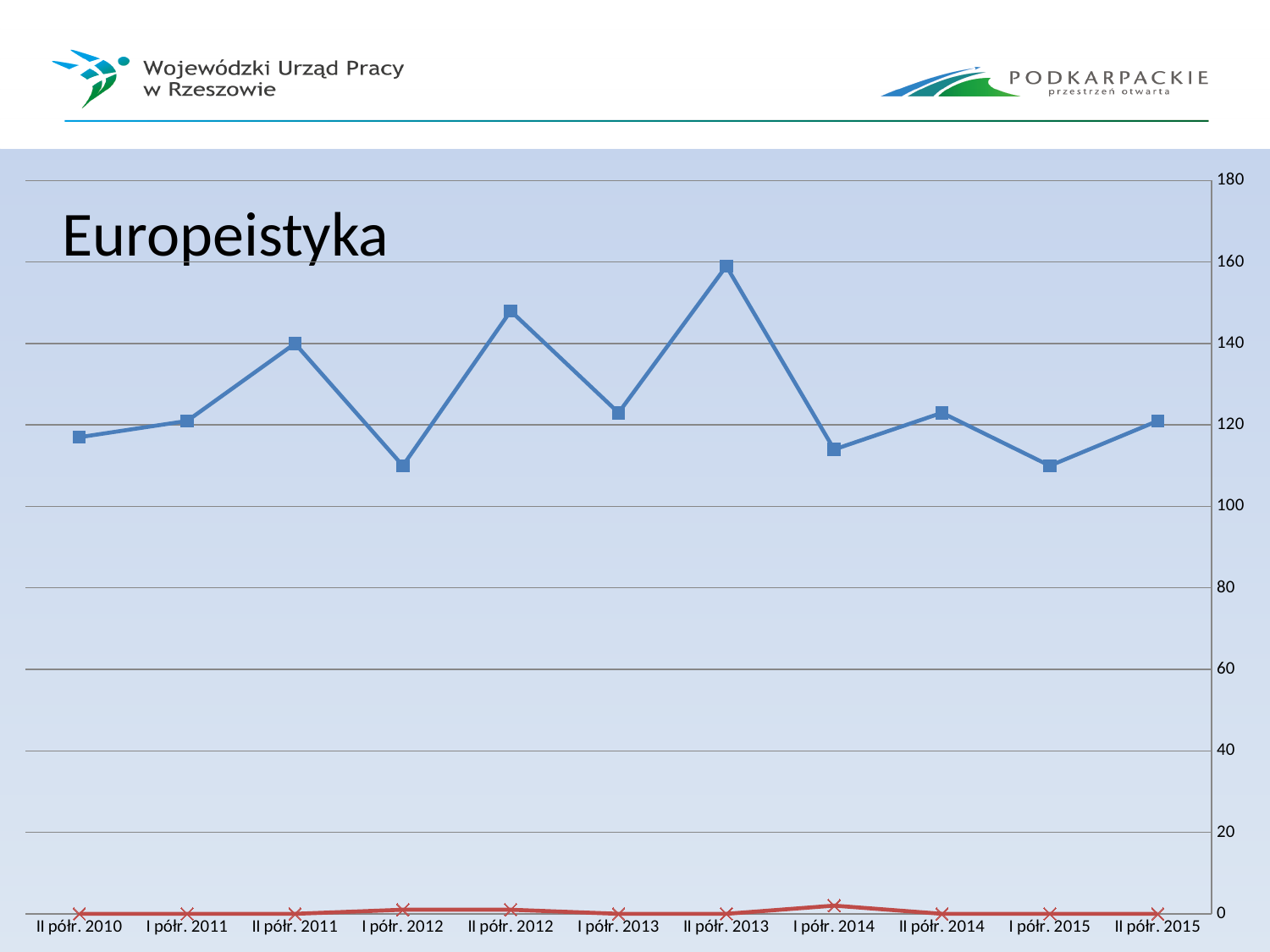
How many time periods are shown on the x axis? 11 Which has the larger value on the blue line: II półr. 2012 or I półr. 2013? II półr. 2012 In which period does the blue line reach its highest value? II półr. 2013 Does the blue line rise or fall from II półr. 2010 to II półr. 2011? rise Is the value of the blue line for I półr. 2015 greater or less than 120? less Is the value of the blue line for II półr. 2013 greater or less than 140? greater Which has the larger value on the blue line: II półr. 2013 or I półr. 2014? II półr. 2013 Is the value of the blue line for II półr. 2012 greater or less than 140? greater What is the title of the chart? Europeistyka What kind of chart is shown on the slide? line chart What colour is the line that stays near zero along the bottom of the chart? red